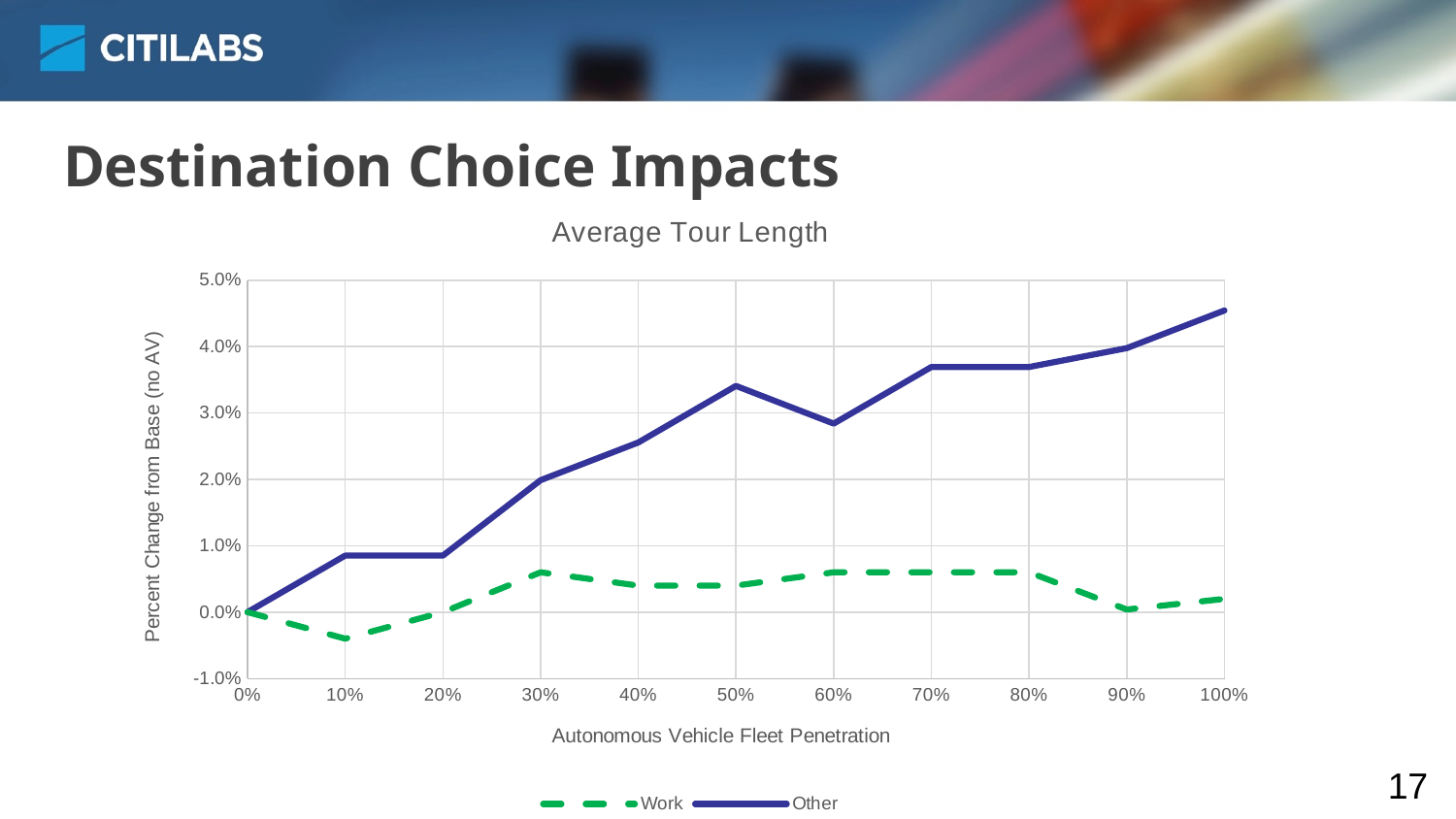
How many fleet penetration points are plotted along the x axis? 11 Is the value for the Other series at 100% fleet penetration greater or less than 4.0%? greater Is the value for the Other series at 50% fleet penetration greater or less than 3.0%? greater What is the label of the x axis? Autonomous Vehicle Fleet Penetration What kind of chart is shown on the slide? line chart At which fleet penetration level does the Other series reach its highest value? 100% What is the title of the chart? Average Tour Length At which fleet penetration level does the Work series reach its lowest value? 10% Is the value for the Work series at 10% fleet penetration greater or less than 0.0%? less How many series does the legend list? 2 At 50% fleet penetration, which series has the higher value, Work or Other? Other Does the Other series generally rise or fall as fleet penetration increases from 0% to 100%? rise